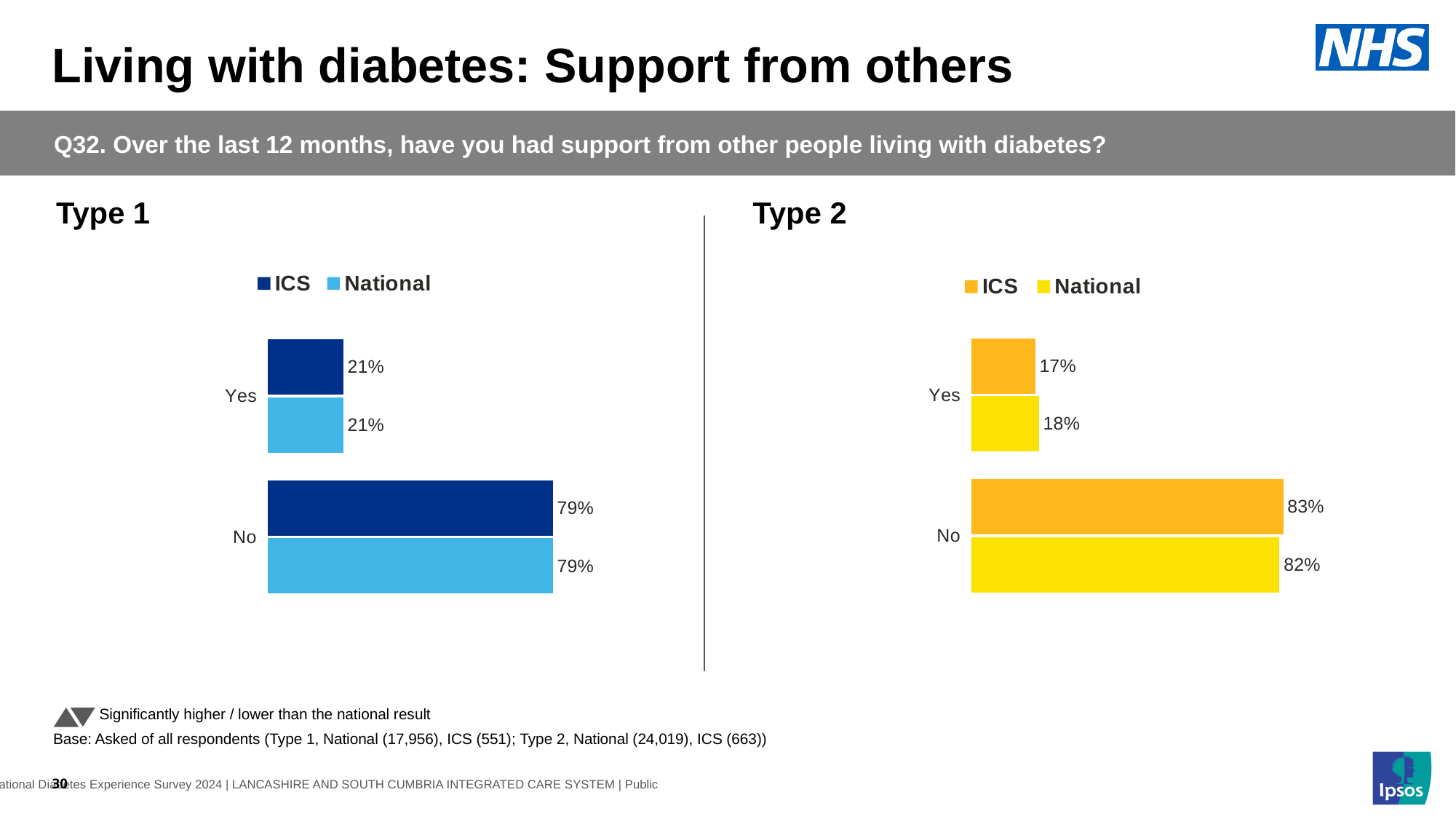
In the Type 1 chart, what is the ICS value for Yes? 21% In the Type 2 chart, is the ICS value for No larger or smaller than the ICS value for Yes? larger In the Type 2 chart, what is the ICS value for No? 83% In the Type 1 chart, what is the difference between the ICS values for No and Yes? 58% What kind of chart is the Type 2 chart? bar chart In the Type 1 chart, which category has the lowest National value? Yes In the Type 2 chart, what is the National value for No? 82% In the Type 1 chart, what is the National value for No? 79% In the Type 2 chart, what is the difference between the ICS and National values for Yes? 1% In the Type 2 chart, which category has the highest ICS value? No In the Type 2 chart, what is the ICS value for Yes? 17% How many series does the legend of the Type 1 chart list? 2